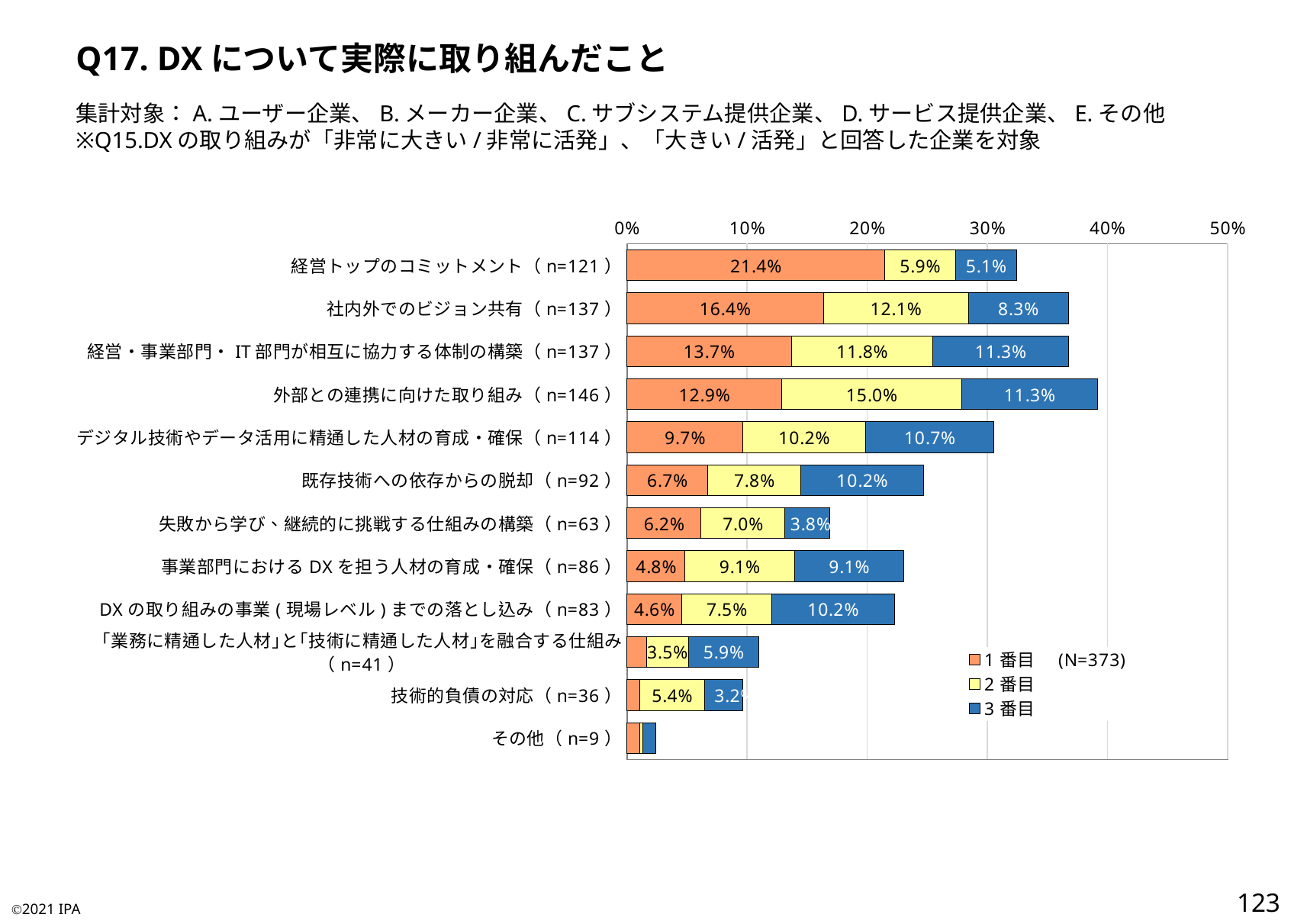
What kind of chart is shown on the slide? Stacked bar chart Which has the larger 2番目 value: 社内外でのビジョン共有 or 経営・事業部門・IT部門が相互に協力する体制の構築? 社内外でのビジョン共有 How many categories are shown on the chart? 12 What is the 3番目 value for 既存技術への依存からの脱却 (n=92)? 10.2% Is the total bar for その他 (n=9) greater or less than 10%? less How many series does the legend list? 3 Which category has the highest 1番目 value? 経営トップのコミットメント (n=121) Which category has the longest total stacked bar? 外部との連携に向けた取り組み (n=146) What is the 1番目 value for 経営トップのコミットメント (n=121)? 21.4% What is the total of the stacked bar for 社内外でのビジョン共有 (n=137)? 36.8% What is the 2番目 value for 外部との連携に向けた取り組み (n=146)? 15.0% What is the difference between the 1番目 values for 経営トップのコミットメント and 社内外でのビジョン共有? 5.0%